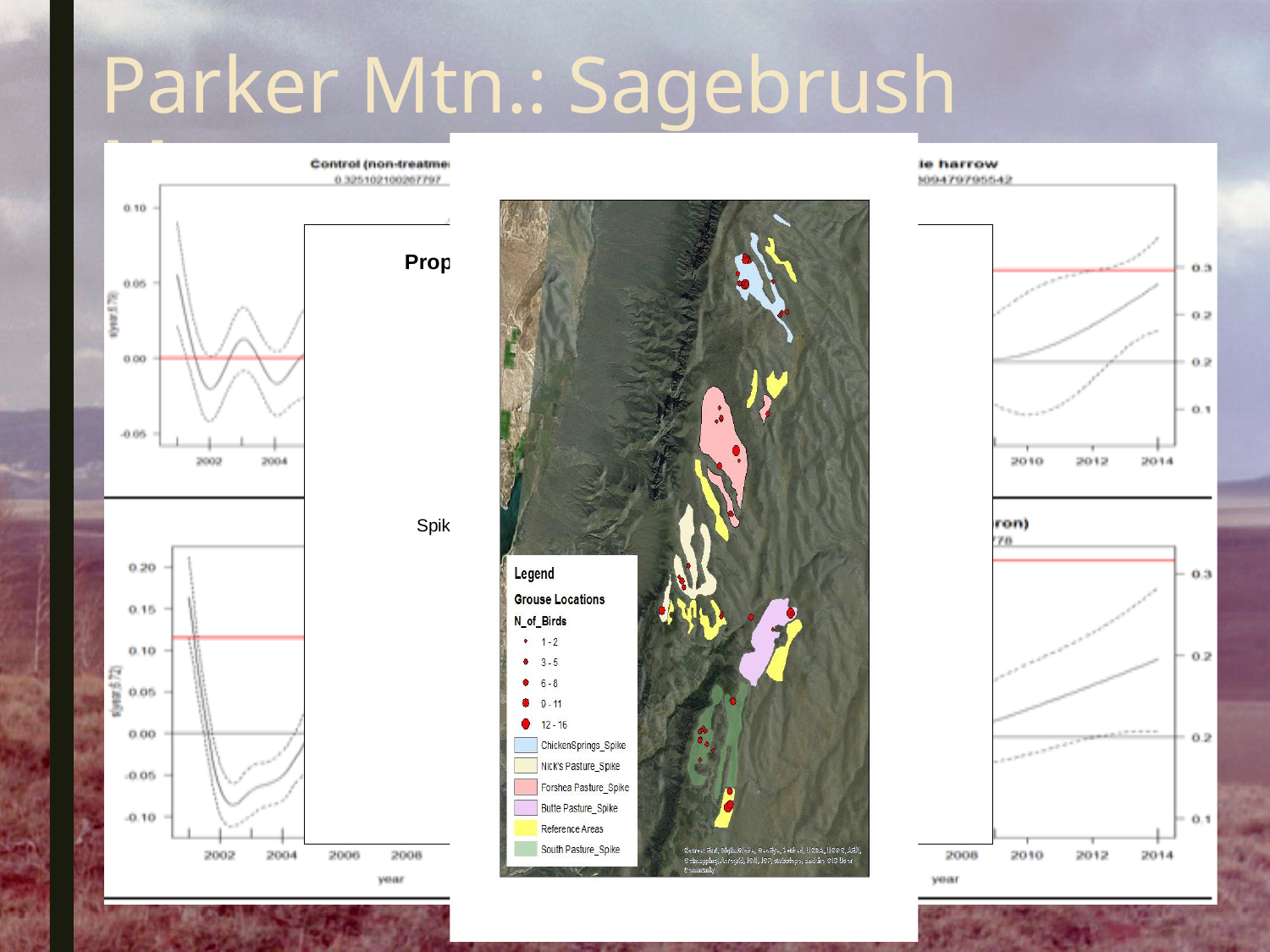
What is the x-axis label on the bottom-left chart? year In the top-right chart, does the solid line rise or fall from 2010 to 2014? rise How many area categories (Spike pastures and Reference Areas) does the map legend list? 6 In the bottom-right chart, does the solid line rise or fall from 2008 to 2014? rise What is the smallest N_of_Birds class shown in the map legend? 1 - 2 What colour represents Reference Areas in the map legend? yellow What kind of chart is the top-left chart titled 'Control (non-treatment)'? line chart How many N_of_Birds size classes does the map legend list? 5 What is the largest N_of_Birds class shown in the map legend? 12 - 16